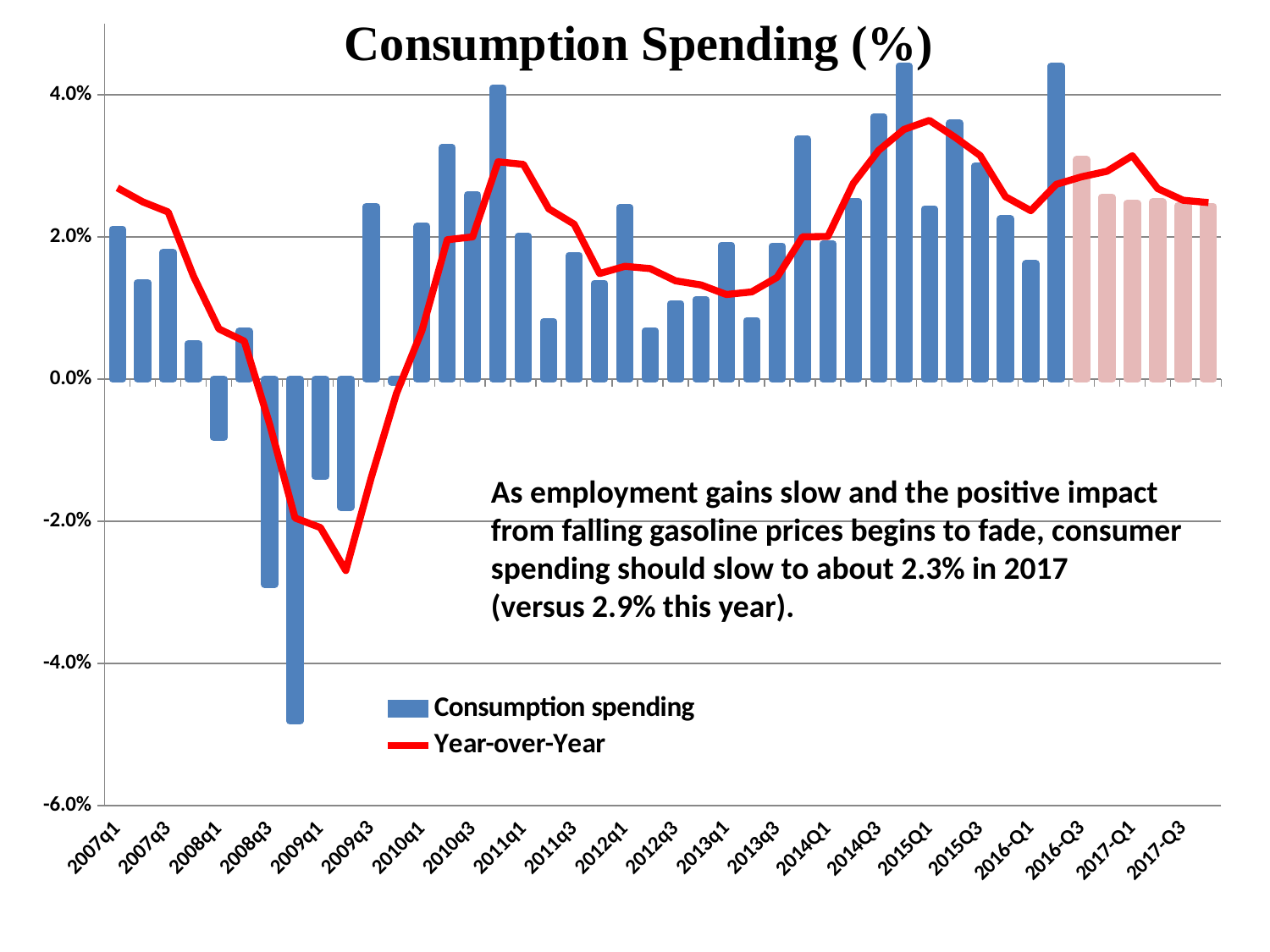
Is the Consumption spending value for 2015Q1 greater or less than 4.0%? less Is the Consumption spending value for 2012q3 greater or less than 2.0%? less Does the Year-over-Year line rise or fall from 2007q1 to 2009q1? fall Which series is drawn as a red line? Year-over-Year What is the title of the chart? Consumption Spending (%) Which has the larger Consumption spending value, 2015Q1 or 2016-Q1? 2015Q1 Which has the larger Consumption spending value, 2008q3 or 2009q1? 2009q1 What kind of chart is this? A bar chart with a line series Is the Consumption spending value for 2009q1 greater or less than -2.0%? greater How many series does the legend list? 2